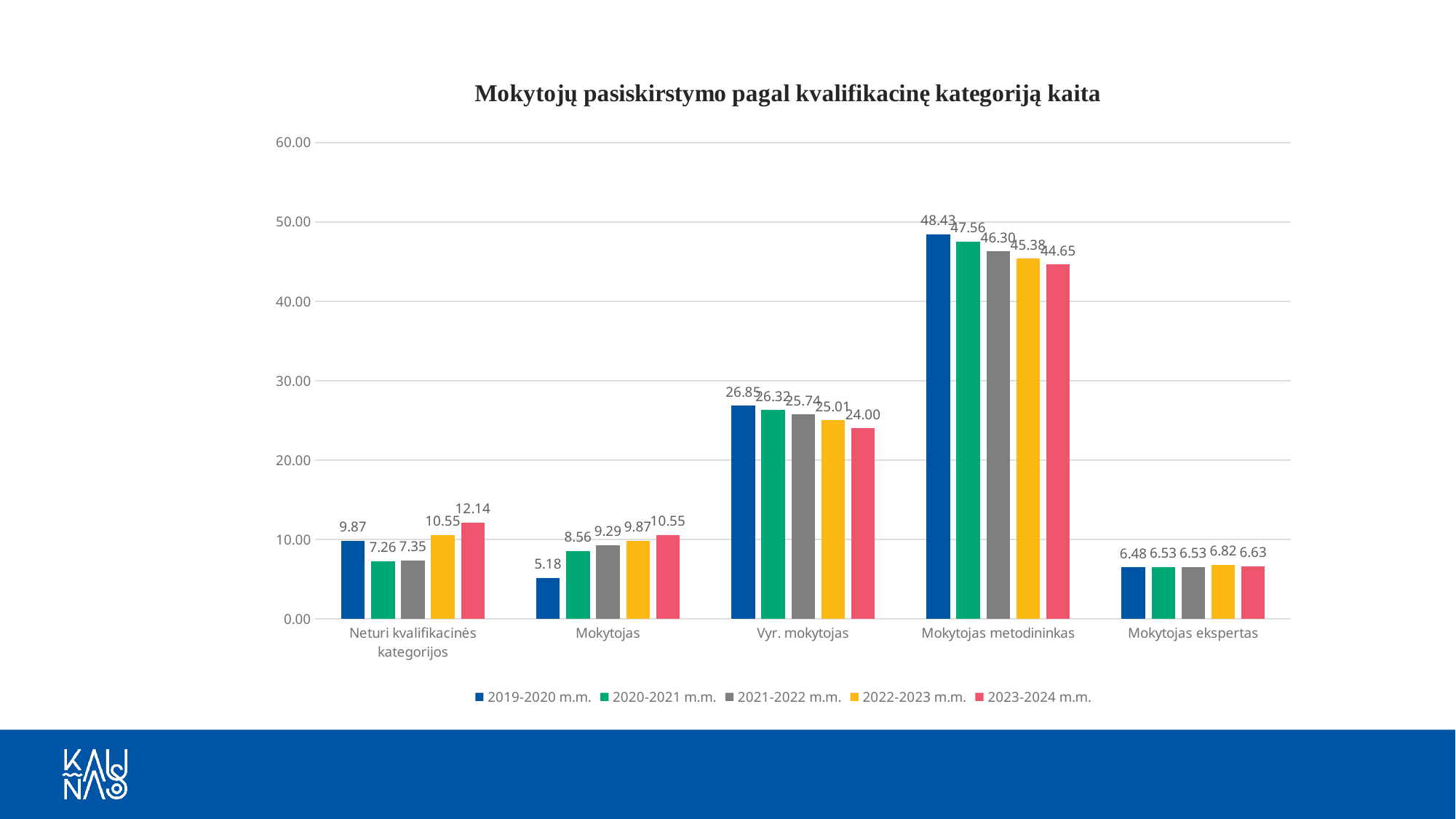
Which category has the lowest value in the 2019-2020 m.m. series? Mokytojas Do the values for Mokytojas rise or fall from 2019-2020 m.m. to 2023-2024 m.m.? rise Do the values for Vyr. mokytojas rise or fall from 2019-2020 m.m. to 2023-2024 m.m.? fall For Vyr. mokytojas, which is larger: the 2019-2020 m.m. value or the 2023-2024 m.m. value? 2019-2020 m.m. Which category has the highest value in the 2021-2022 m.m. series? Mokytojas metodininkas What is the difference between the 2019-2020 m.m. and 2023-2024 m.m. values for Mokytojas metodininkas? 3.78 What is the value for Mokytojas metodininkas in the 2023-2024 m.m. series? 44.65 What is the value for Neturi kvalifikacinės kategorijos in the 2023-2024 m.m. series? 12.14 How many categories are shown on the x axis? 5 How many series does the legend list? 5 What is the value for Mokytojas in the 2019-2020 m.m. series? 5.18 What kind of chart is shown on the slide? bar chart